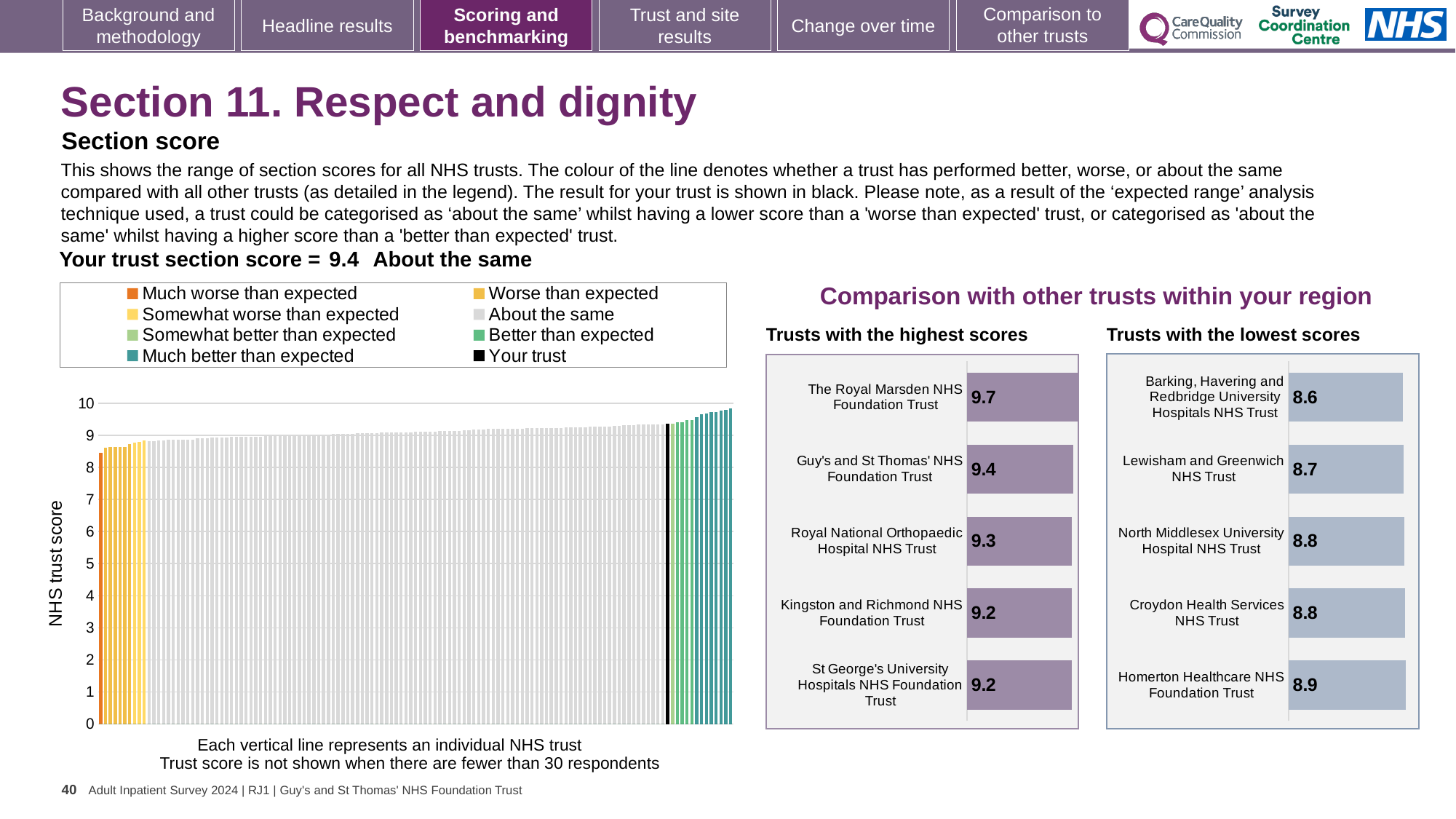
In the 'Trusts with the lowest scores' chart, which trust has the lowest score? Barking, Havering and Redbridge University Hospitals NHS Trust In the 'Trusts with the highest scores' chart, what is the difference between the scores of The Royal Marsden NHS Foundation Trust and Guy's and St Thomas' NHS Foundation Trust? 0.3 In the 'Trusts with the lowest scores' chart, what is the score for Barking, Havering and Redbridge University Hospitals NHS Trust? 8.6 What kind of chart is the large chart on the left showing NHS trust scores? bar chart In the 'Trusts with the highest scores' chart, which trust has the highest score? The Royal Marsden NHS Foundation Trust How many entries does the legend of the large chart on the left list? 8 What is the y-axis title of the large chart on the left? NHS trust score How many trusts are shown in the 'Trusts with the highest scores' chart? 5 What is the section score for your trust shown on the slide? 9.4 In the 'Trusts with the lowest scores' chart, which has the higher score: Lewisham and Greenwich NHS Trust or Homerton Healthcare NHS Foundation Trust? Homerton Healthcare NHS Foundation Trust In the 'Trusts with the highest scores' chart, what is the score for The Royal Marsden NHS Foundation Trust? 9.7 In the large chart on the left, is the value for the black 'Your trust' line greater or less than 9? greater